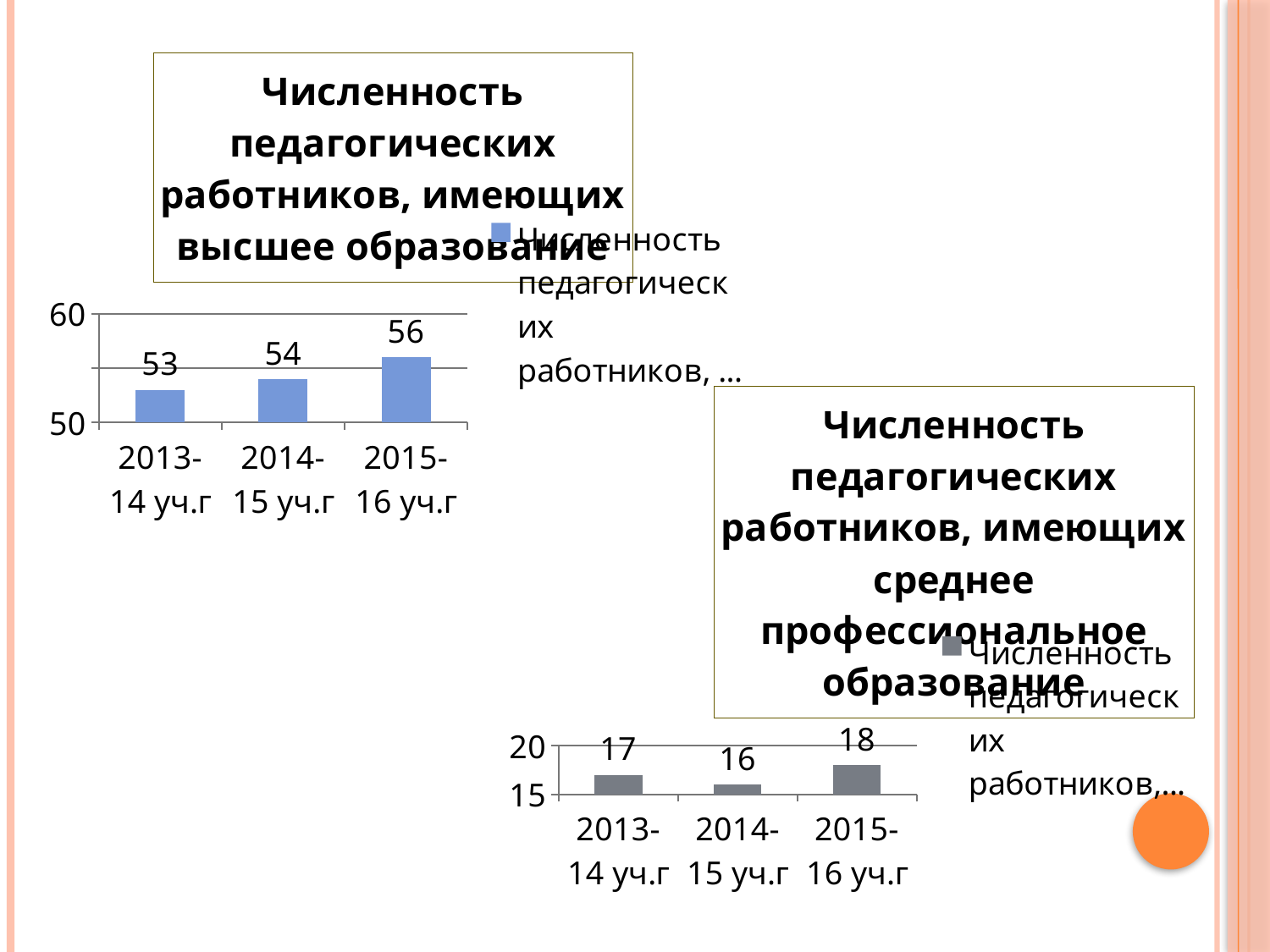
In the bottom-right chart (secondary vocational education), what is the value for 2014-15 уч.г? 16 How many categories are shown on the x axis of the top-left chart (higher education)? 3 In the top-left chart (higher education), what is the difference between the values for 2015-16 уч.г and 2013-14 уч.г? 3 In the bottom-right chart (secondary vocational education), which year has the lowest value? 2014-15 уч.г In the bottom-right chart (secondary vocational education), what is the difference between the values for 2013-14 уч.г and 2014-15 уч.г? 1 In the top-left chart (higher education), what is the value for 2013-14 уч.г? 53 In the bottom-right chart (secondary vocational education), which is larger: the value for 2013-14 уч.г or 2015-16 уч.г? 2015-16 уч.г In the top-left chart (higher education), do the values rise or fall from 2013-14 to 2015-16? rise In the top-left chart (higher education), which year has the highest value? 2015-16 уч.г What kind of chart is the bottom-right chart (secondary vocational education)? bar chart In the top-left chart (higher education), what is the value for 2015-16 уч.г? 56 In the bottom-right chart (secondary vocational education), what is the value for 2015-16 уч.г? 18